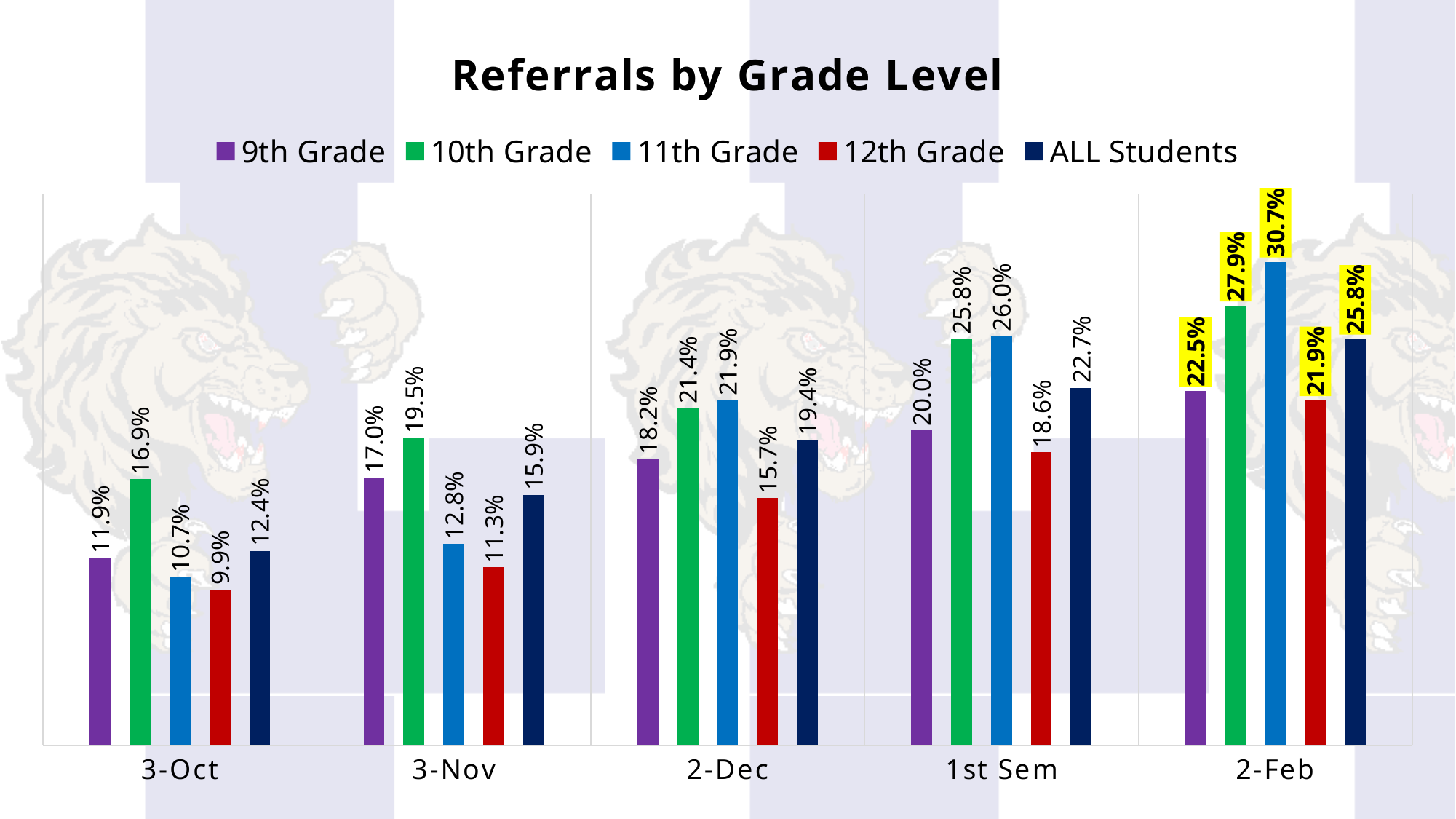
Which grade level has the lowest value at 3-Nov? 12th Grade How many series does the legend list? 5 Which is larger at 1st Sem: the 9th Grade value or the 12th Grade value? 9th Grade How many categories are shown on the x axis? 5 What is the value for ALL Students at 1st Sem? 22.7% Do the ALL Students values rise or fall from 3-Oct to 2-Feb? rise What is the value for 11th Grade at 2-Feb? 30.7% What is the title of the chart? Referrals by Grade Level What is the difference between the 10th Grade and 9th Grade values at 2-Feb? 5.4% Which grade level has the highest value at 2-Dec? 11th Grade What is the value for 12th Grade at 3-Oct? 9.9% What kind of chart is this? bar chart